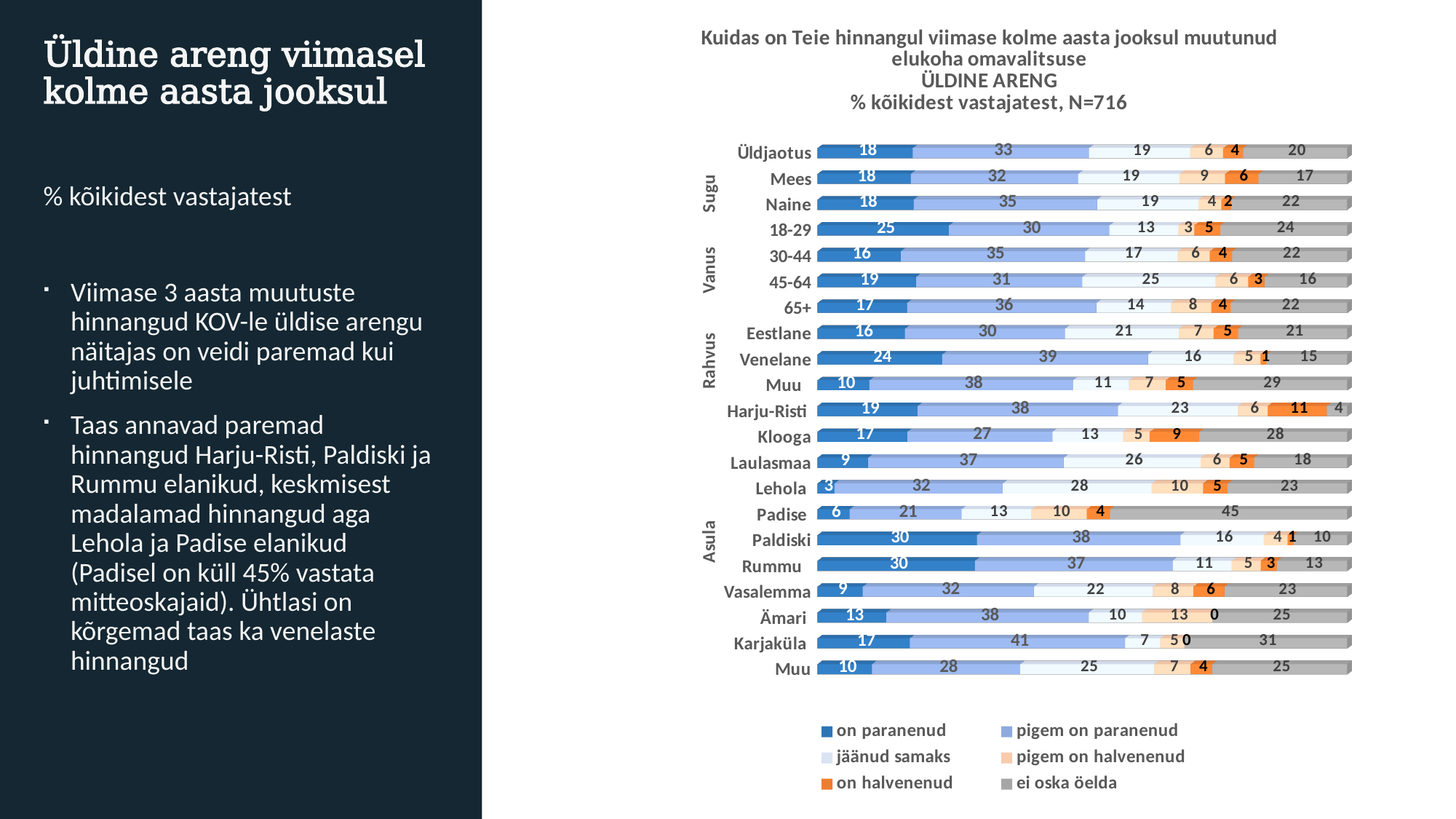
What is the 'ei oska öelda' value for Padise? 45 What is the total of the stacked bar for Üldjaotus? 100 What is the difference between the 'ei oska öelda' values for Padise and Paldiski? 35 Which category has the lowest 'on paranenud' value? Lehola Which has a larger 'on paranenud' value, Eestlane or Venelane? Venelane Which category has the highest 'ei oska öelda' value? Padise Which category has the highest 'pigem on paranenud' value? Karjaküla What is the 'on halvenenud' value for Harju-Risti? 11 What type of chart is shown on the slide? stacked bar chart How many series does the legend list? 6 What is the 'on paranenud' value for Venelane? 24 How many categories (rows) are plotted in the chart? 21